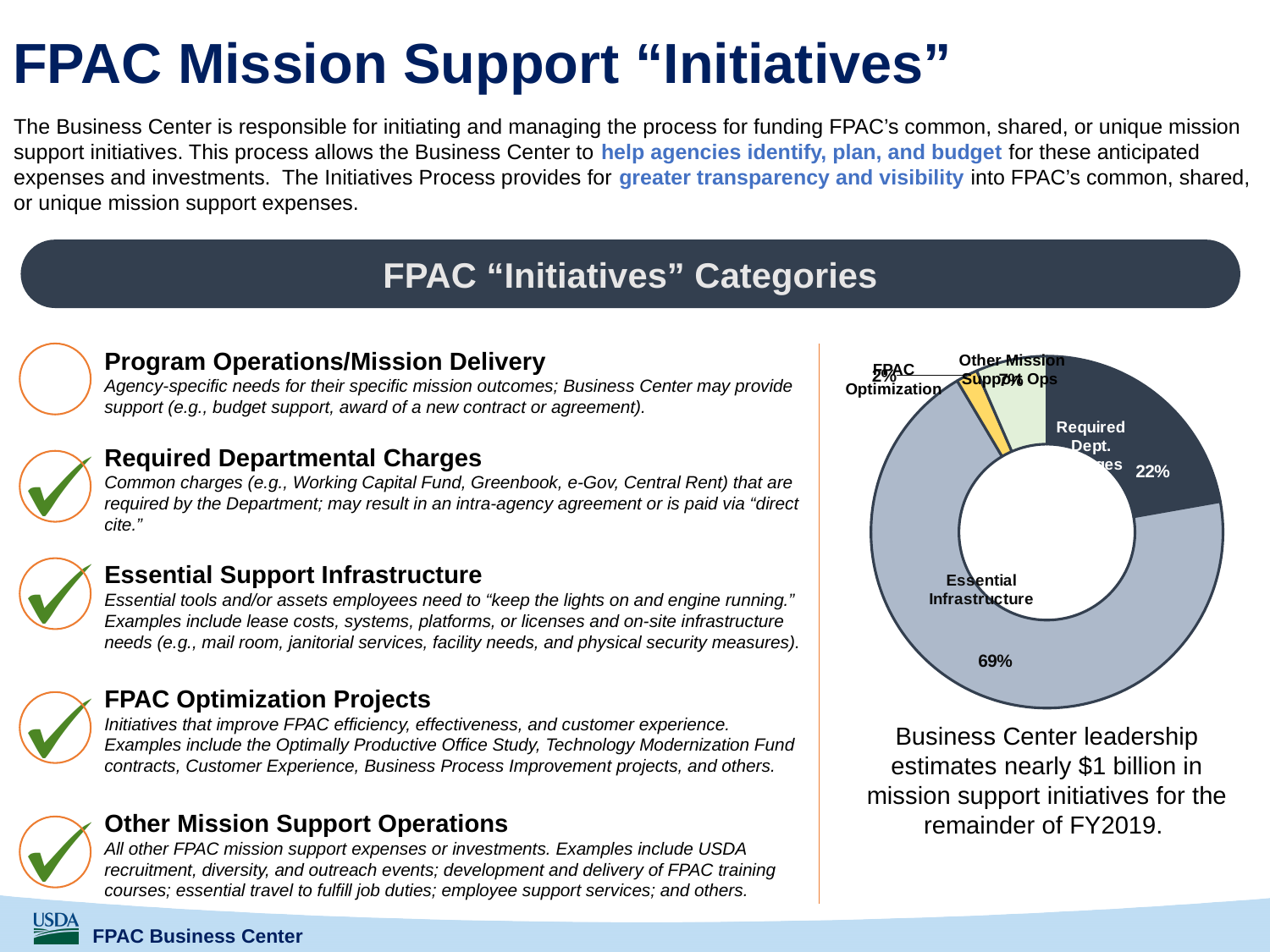
Which is larger in the pie chart, Required Dept. Charges or FPAC Optimization? Required Dept. Charges What share of the pie chart is Essential Infrastructure? 69% Is the share for Essential Infrastructure in the pie chart greater or less than 50%? greater What share of the pie chart is FPAC Optimization? 2% What is the difference in percentage points between Essential Infrastructure and Required Dept. Charges in the pie chart? 47 What is the combined share of Essential Infrastructure and Required Dept. Charges in the pie chart? 91% How many slices does the pie chart have? 4 What colour is the Essential Infrastructure slice in the pie chart? Light grey-blue Which category has the largest slice in the pie chart? Essential Infrastructure What share of the pie chart is Required Dept. Charges? 22% What kind of chart is shown on the right side of the slide? Pie chart (donut) Which category has the smallest slice in the pie chart? FPAC Optimization